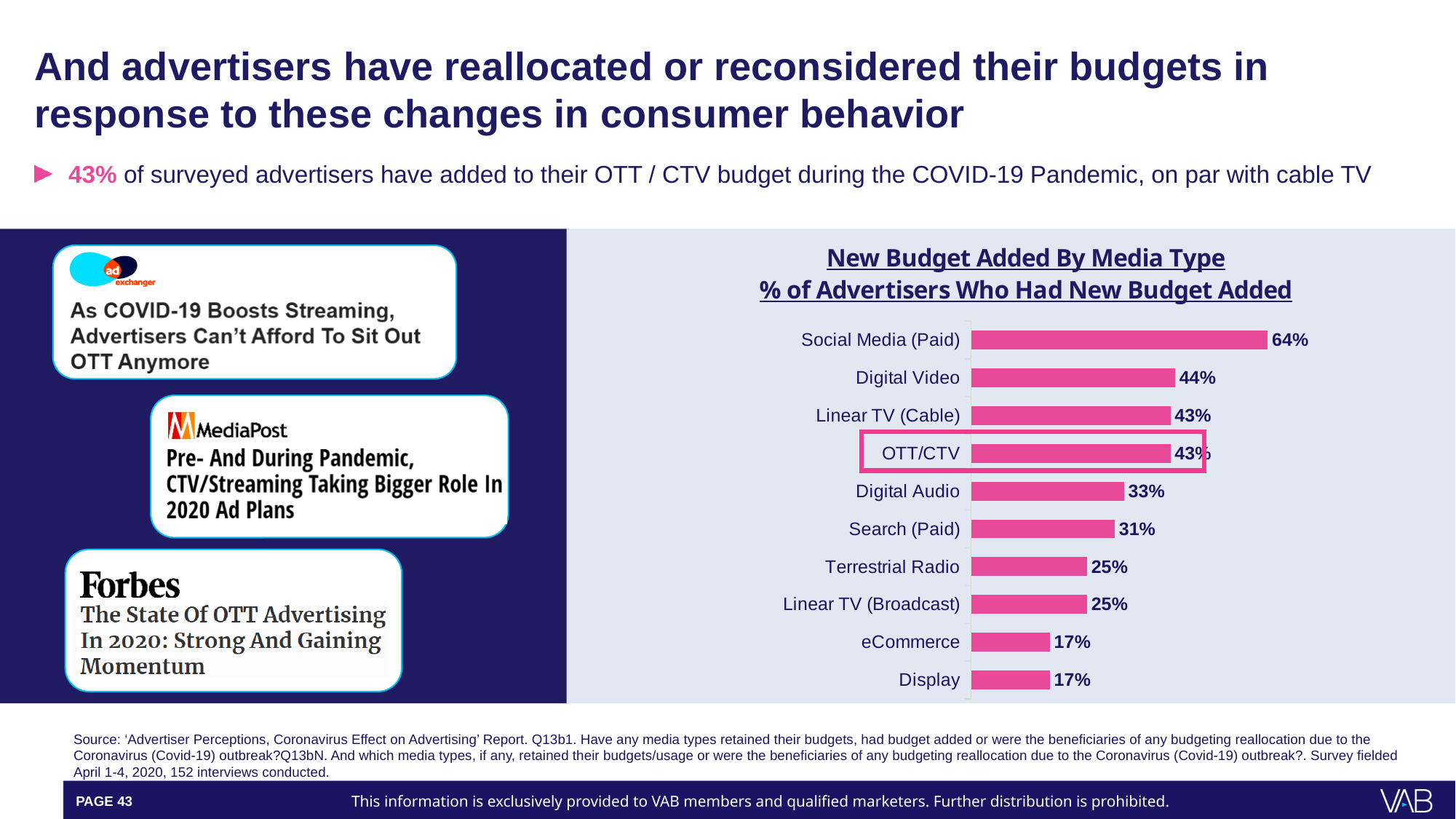
Which is larger, the value for Digital Audio or the value for Terrestrial Radio? Digital Audio What value is shown for eCommerce? 17% What is the value shown for Digital Audio? 33% What is the difference between the values for Social Media (Paid) and Digital Video? 20% What is the difference between the values for OTT/CTV and Search (Paid)? 12% What kind of chart is used to show new budget added by media type? Bar chart What is the title of the chart? New Budget Added By Media Type % of Advertisers Who Had New Budget Added Which category in the chart is highlighted with a box outline? OTT/CTV Which media type has the highest percentage of advertisers who had new budget added? Social Media (Paid) What is the value shown for Linear TV (Broadcast)? 25% What percentage of advertisers had new budget added for Social Media (Paid)? 64% How many media types are shown in the chart? 10